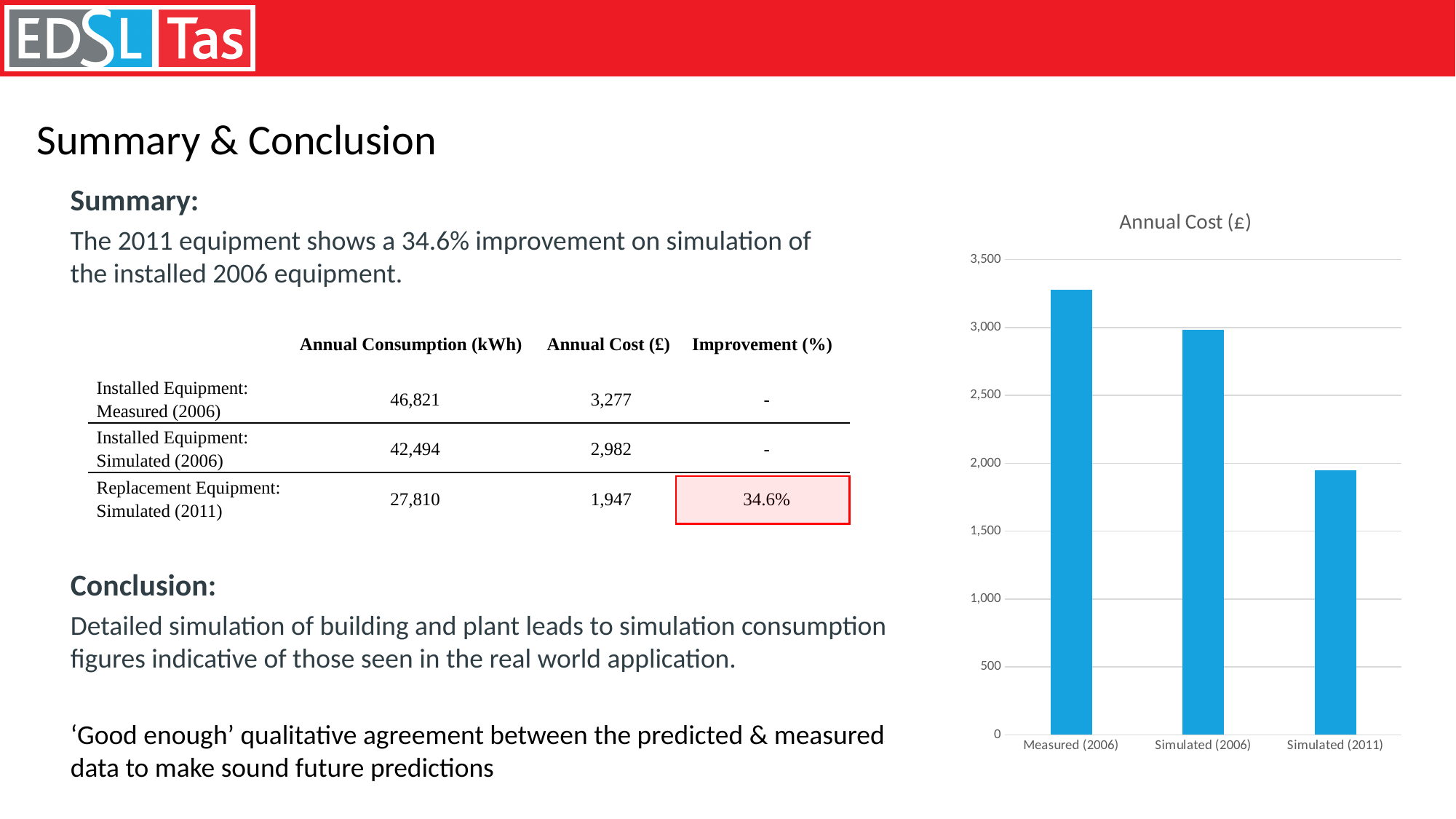
Do the annual cost values rise or fall from left to right across the chart? fall What is the annual cost (£) for Simulated (2011), as printed in the table on the slide? 1,947 What is the title of the chart? Annual Cost (£) Which is larger, the annual cost for Simulated (2006) or Simulated (2011)? Simulated (2006) How many bars are shown in the Annual Cost (£) chart? 3 What is the difference in annual cost (£) between Measured (2006) and Simulated (2011), using the values printed in the table? 1,330 Is the value for Simulated (2011) greater or less than 2,000? less Is the value for Measured (2006) greater or less than 3,000? greater Is the value for Simulated (2006) greater or less than 2,500? greater What type of chart is shown on the slide? bar chart Which category has the lowest annual cost in the chart? Simulated (2011) Which category has the highest annual cost in the chart? Measured (2006)